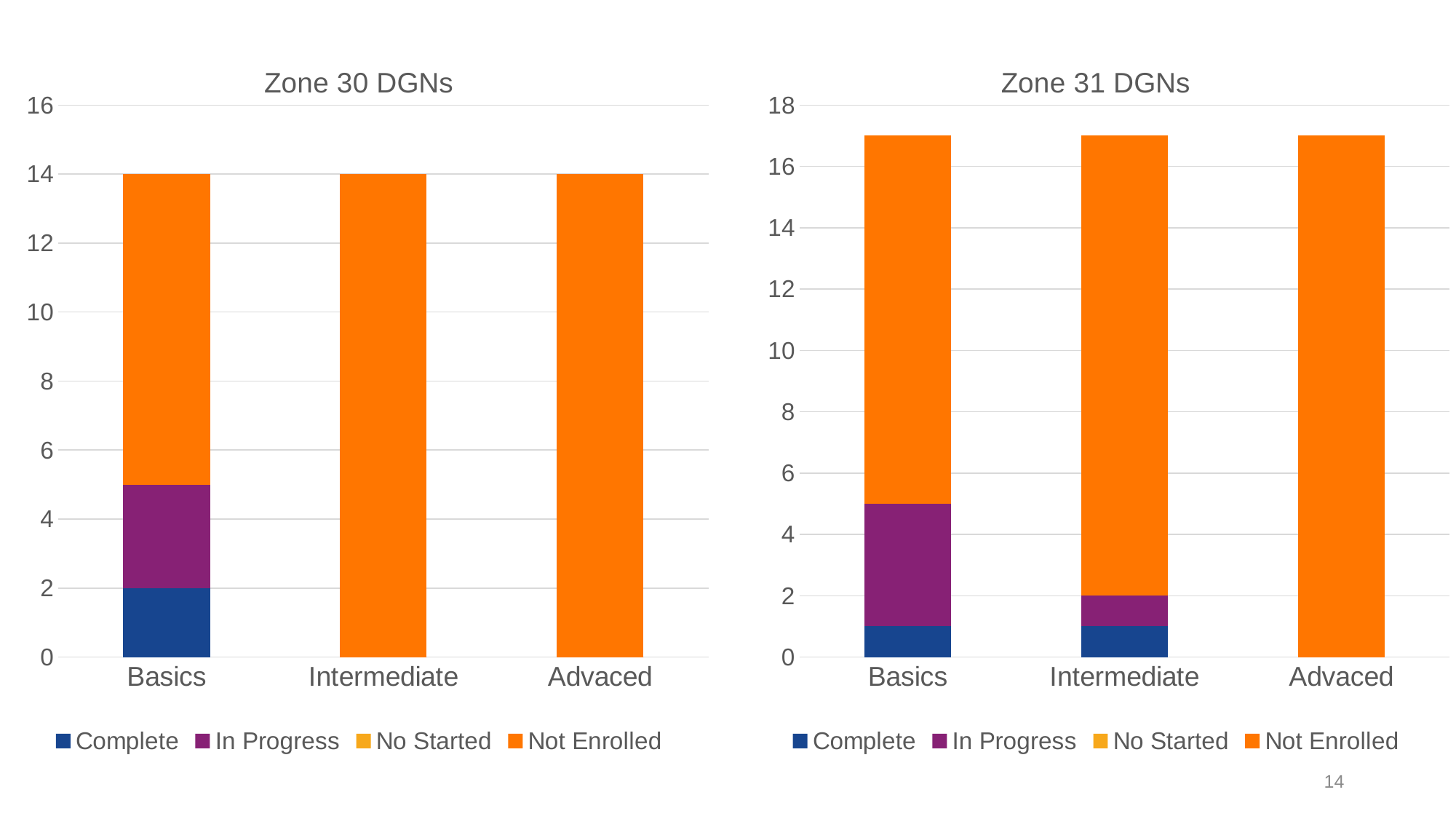
In the Zone 31 DGNs chart, is the total for Basics greater or less than 16? greater Is the Complete value for Basics larger in the Zone 30 DGNs chart or the Zone 31 DGNs chart? Zone 30 DGNs How many categories are shown on the x axis of the Zone 30 DGNs chart? 3 How many series does the legend of the Zone 31 DGNs chart list? 4 What kind of chart is the Zone 30 DGNs chart? Stacked bar chart In the Zone 30 DGNs chart, what is the Not Enrolled value for Intermediate? 14 In the Zone 30 DGNs chart, what is the Complete value for Basics? 2 In the Zone 30 DGNs chart, what is the total height of the Basics bar? 14 Which category has the largest Not Enrolled value in the Zone 31 DGNs chart? Advaced What colour represents Not Enrolled in the Zone 30 DGNs chart? Orange In the Zone 31 DGNs chart, is the In Progress value for Basics greater or less than 2? greater Which category has the largest Complete value in the Zone 30 DGNs chart? Basics